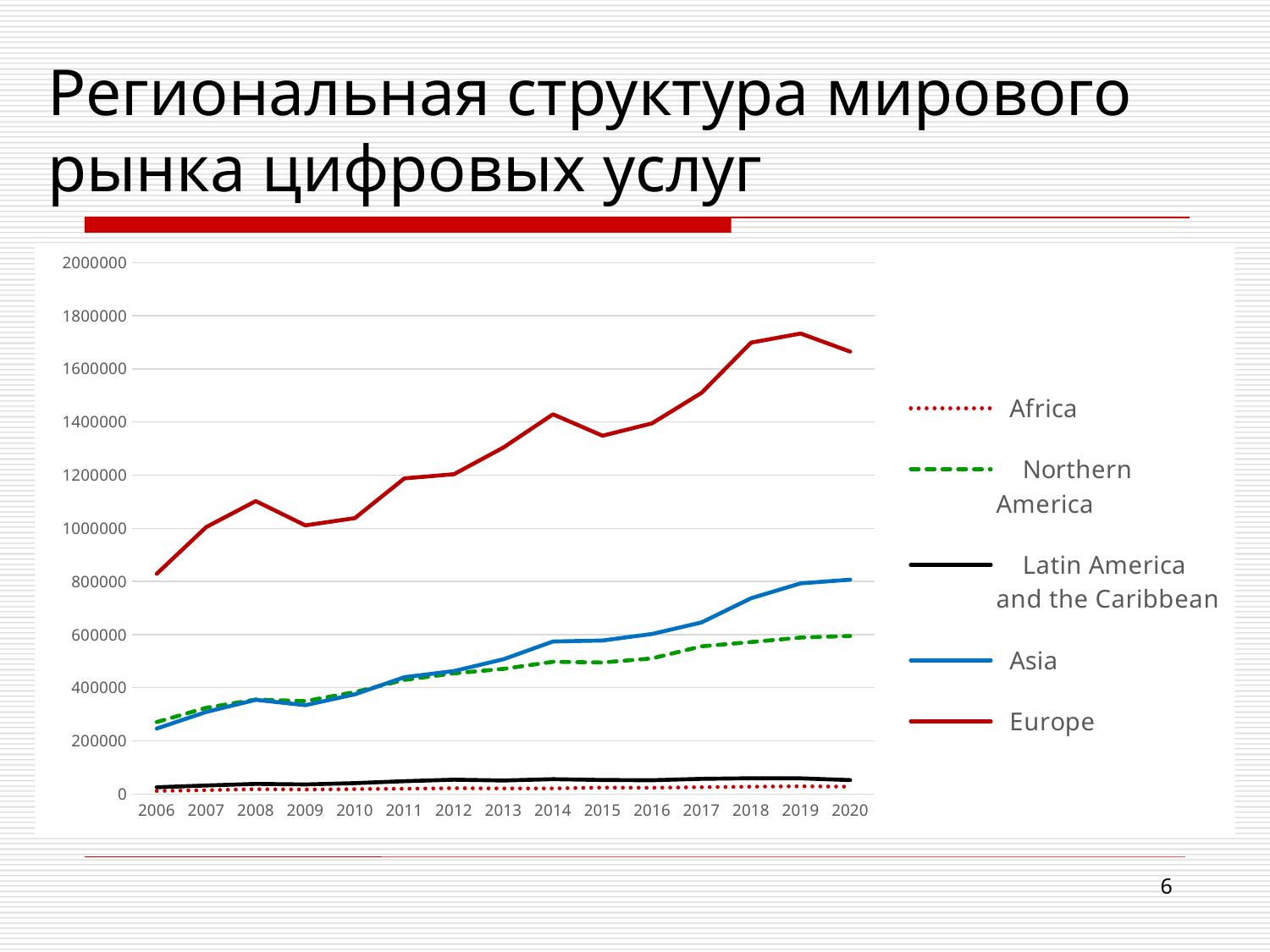
How many years are shown along the x axis? 15 Is the value for Europe in 2019 greater or less than 1600000? greater In 2020, which is larger: the value for Asia or the value for Northern America? Asia Which colour is used for the Asia line? blue Which region has the lowest values throughout the chart? Africa Is the value for Latin America and the Caribbean in 2020 greater or less than 200000? less What kind of chart is shown on the slide? line chart Is the value for Europe in 2008 greater or less than 1000000? greater Which region has the highest values throughout the chart? Europe Does the value for Europe generally rise or fall from 2006 to 2020? rise How many series does the legend list? 5